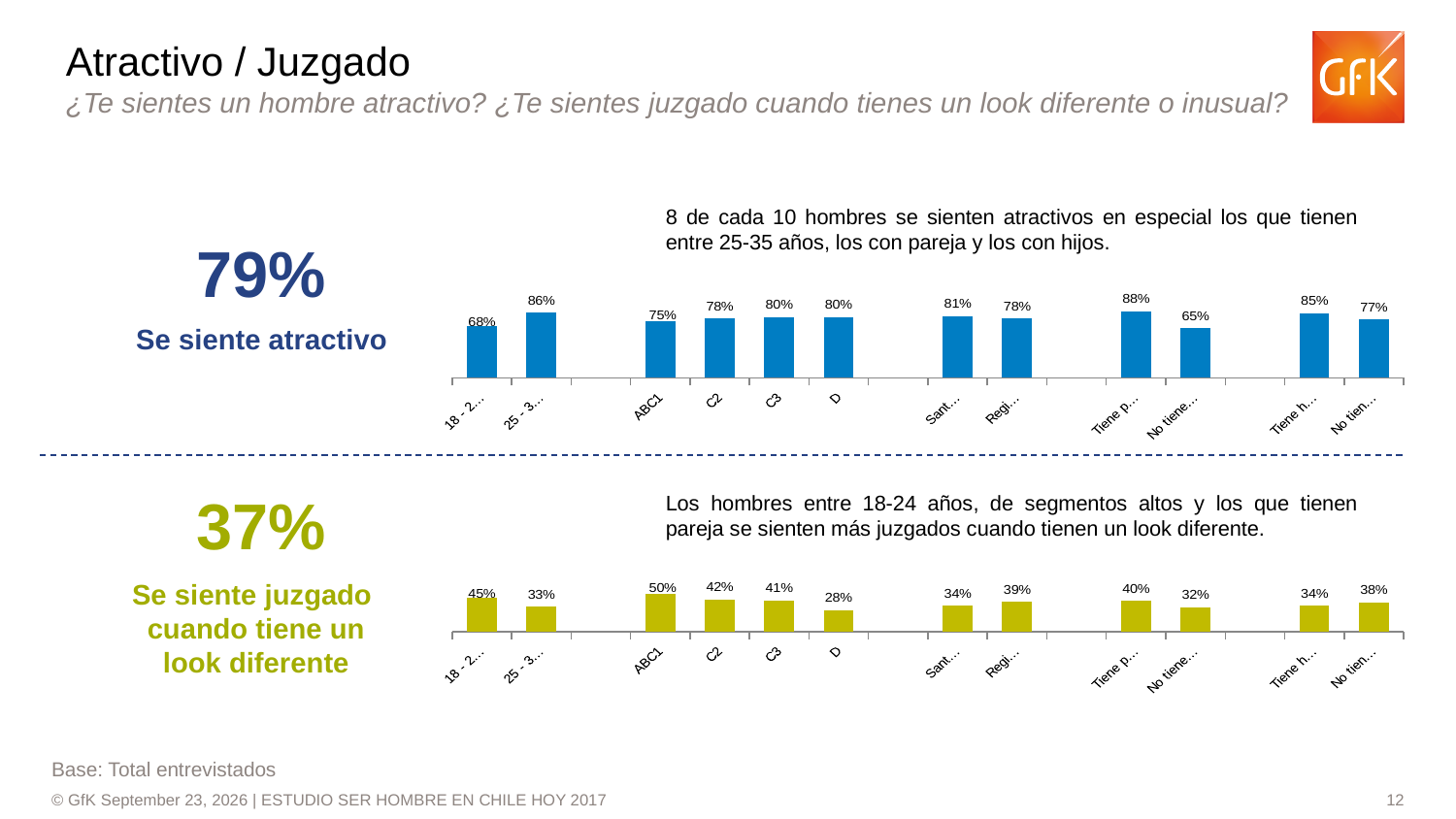
In the top chart (Se siente atractivo), what is the value for ABC1? 75% In the bottom chart (Se siente juzgado cuando tiene un look diferente), what is the difference between the values for ABC1 and C2? 8 percentage points In the top chart (Se siente atractivo), which is larger, the value for C3 or the value for ABC1? C3 In the bottom chart (Se siente juzgado cuando tiene un look diferente), what is the value for ABC1? 50% In the top chart (Se siente atractivo), what is the value for C2? 78% In the top chart (Se siente atractivo), what is the value for D? 80% How many bars are plotted in the top chart (Se siente atractivo)? 12 In the bottom chart (Se siente juzgado cuando tiene un look diferente), which of the segments ABC1, C2, C3 and D has the highest value? ABC1 In the top chart (Se siente atractivo), what is the highest value shown on any bar? 88% In the top chart (Se siente atractivo), what is the difference between the values for C2 and ABC1? 3 percentage points In the bottom chart (Se siente juzgado cuando tiene un look diferente), which category has the lowest value? D In the bottom chart (Se siente juzgado cuando tiene un look diferente), what is the value for D? 28%